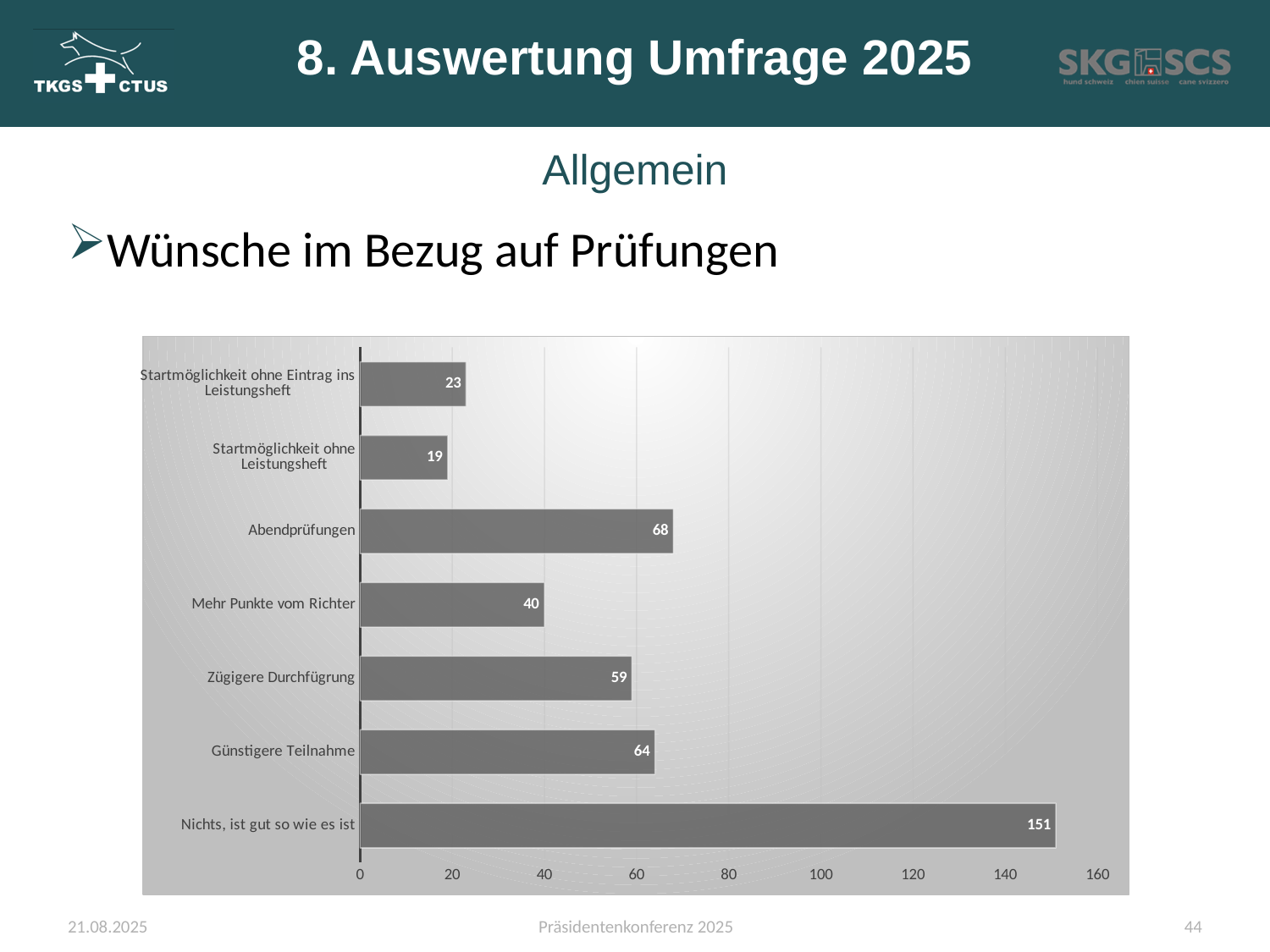
Is the value for "Nichts, ist gut so wie es ist" greater or less than 140? greater Which is larger, the value for "Abendprüfungen" or the value for "Günstigere Teilnahme"? Abendprüfungen What is the value for "Abendprüfungen"? 68 What is the difference between the values for "Startmöglichkeit ohne Eintrag ins Leistungsheft" and "Startmöglichkeit ohne Leistungsheft"? 4 Which category has the lowest value? Startmöglichkeit ohne Leistungsheft What is the difference between the values for "Günstigere Teilnahme" and "Zügigere Durchfügrung"? 5 What is the value for "Mehr Punkte vom Richter"? 40 How many categories are shown in the chart? 7 Which category has the highest value? Nichts, ist gut so wie es ist What kind of chart is shown on the slide? bar chart What is the value for "Startmöglichkeit ohne Leistungsheft"? 19 What is the value for "Nichts, ist gut so wie es ist"? 151